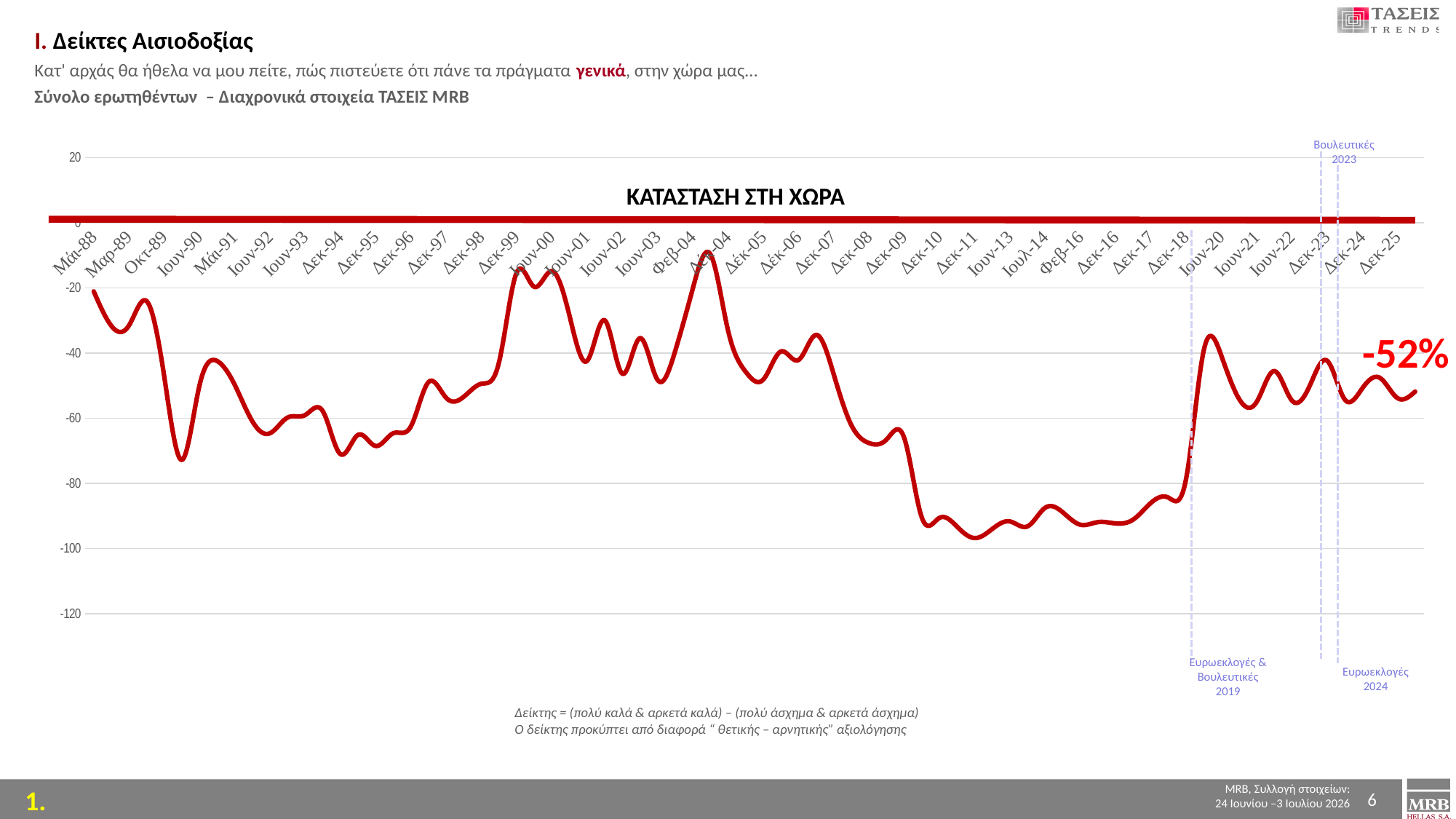
What event is annotated by the dashed line labelled at the top right of the chart? Βουλευτικές 2023 Which is larger, the value for Δεκ-09 or the value for Δεκ-11? Δεκ-09 Is the value for Δεκ-11 greater or less than -80? less What is the latest value labelled at the right end of the line? -52% What is the title shown inside the chart? ΚΑΤΑΣΤΑΣΗ ΣΤΗ ΧΩΡΑ Which is larger, the value for Δεκ-18 or the value for Ιουν-20? Ιουν-20 Is the value for Μάι-88 greater or less than -40? greater Is the value for Ιουν-00 greater or less than -40? greater Does the line rise or fall between Δεκ-18 and Ιουν-20? rise Does the line rise or fall between Δεκ-07 and Δεκ-11? fall What kind of chart is shown on the slide? line chart